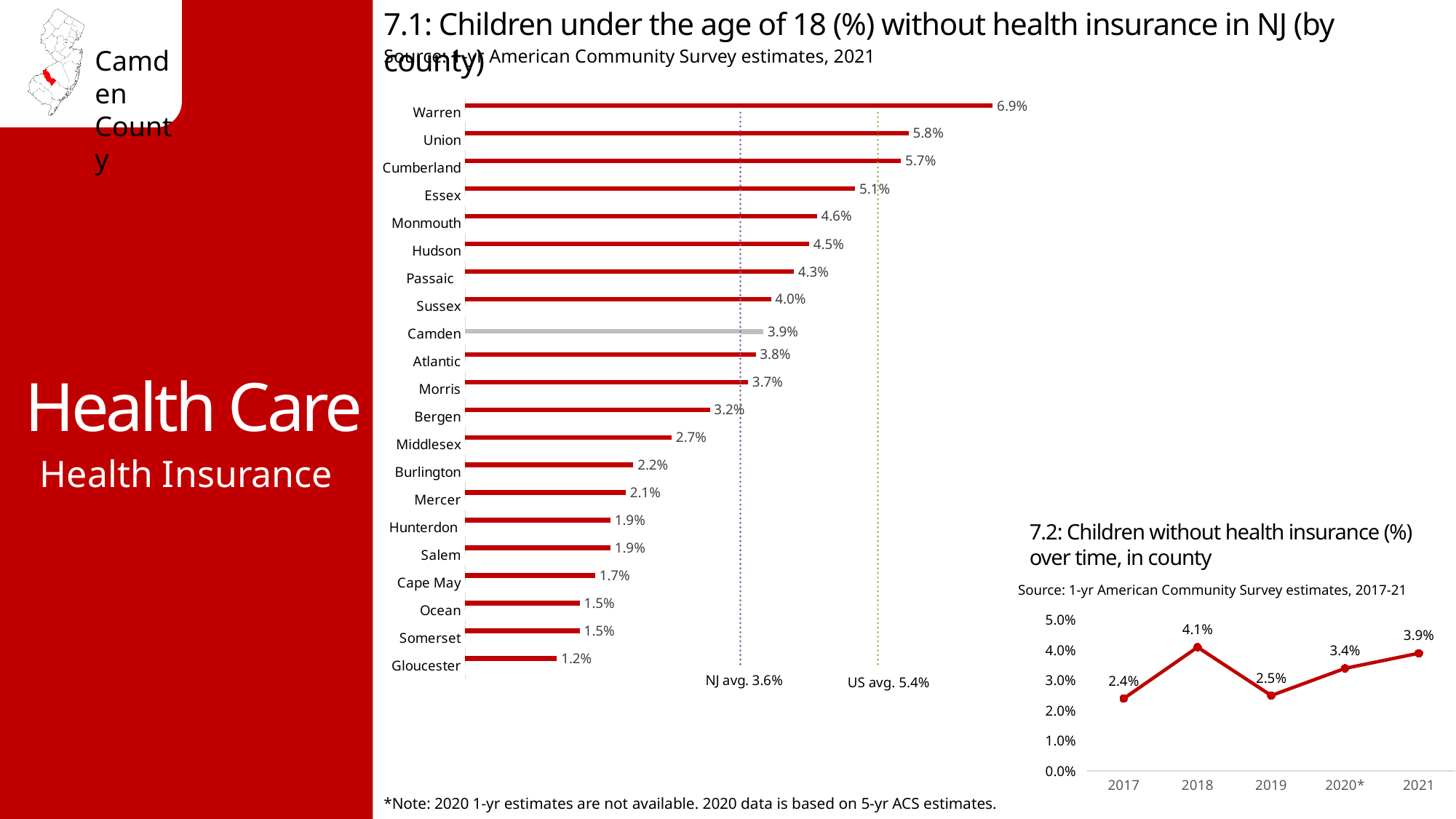
In chart 7.2, what is the difference between the values for 2021 and 2019? 1.4% In chart 7.1, what is the value for Middlesex? 2.7% In chart 7.1, how many counties are shown? 21 What kind of chart is chart 7.2 (children without health insurance over time, in county)? Line chart In chart 7.1, what is the difference between the values for Warren and Gloucester? 5.7% In chart 7.1, which county has the highest percentage of children without health insurance? Warren In chart 7.1, what is the NJ average shown by the dotted reference line? 3.6% In chart 7.1 (children under 18 without health insurance by county), what is the value for Camden? 3.9% In chart 7.2, what is the value for 2018? 4.1% In chart 7.2, which year has the lowest value? 2017 In chart 7.1, which county has a larger value, Hudson or Bergen? Hudson In chart 7.1, which county has the lowest percentage of children without health insurance? Gloucester